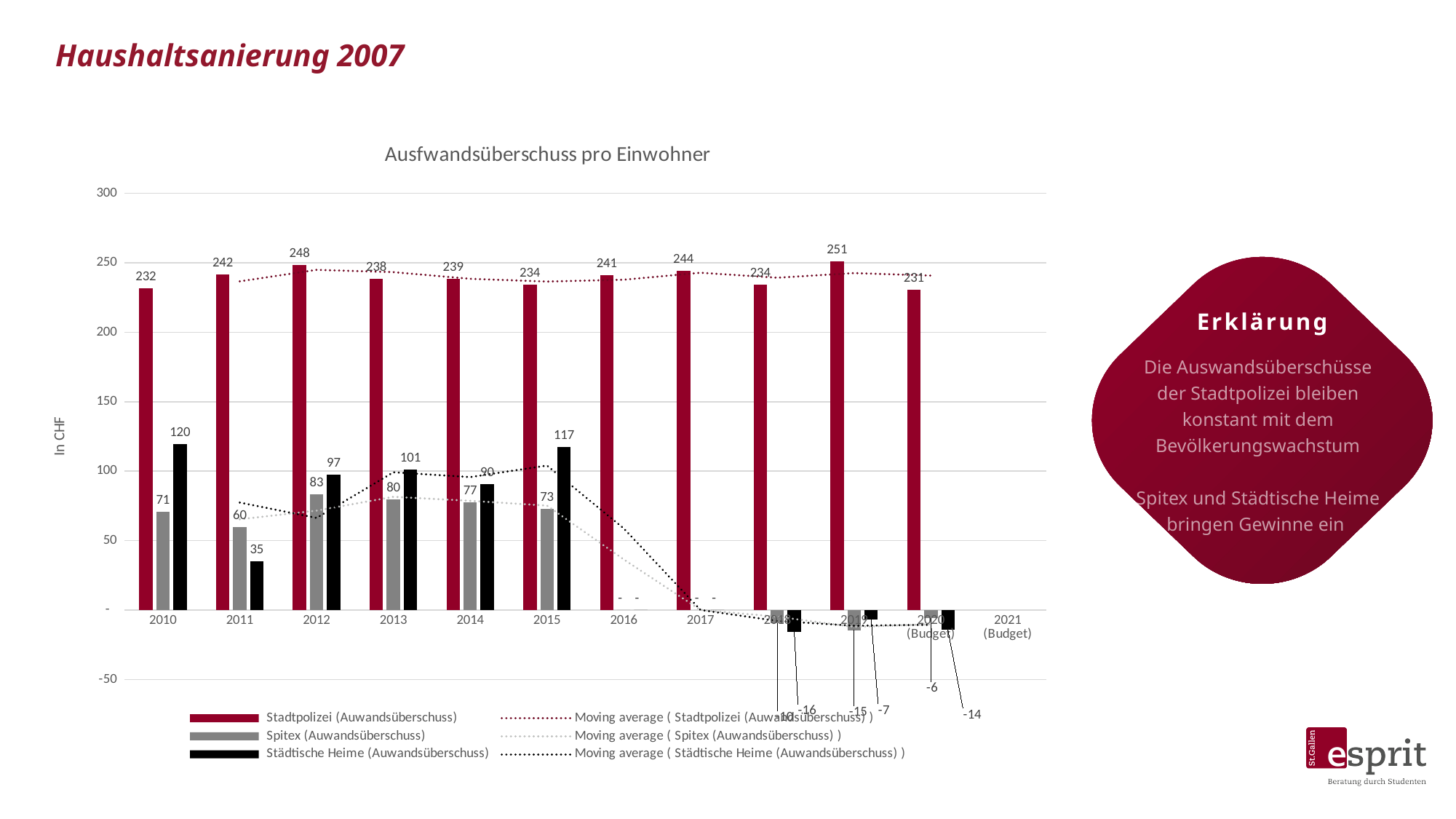
What is the difference between the Städtische Heime value in 2010 and in 2011? 85 What kind of chart is shown on the slide? Bar chart How many year categories are shown on the x axis? 12 What is the value for Stadtpolizei (Auwandsüberschuss) in 2012? 248 How many series does the legend list? 6 What is the label of the y axis? In CHF What is the difference between the Stadtpolizei value in 2019 and in 2020 (Budget)? 20 In 2013, which is larger: the Spitex value or the Städtische Heime value? Städtische Heime In which year is the Stadtpolizei (Auwandsüberschuss) value highest? 2019 In which year is the Städtische Heime (Auwandsüberschuss) value highest? 2010 What is the value for Spitex (Auwandsüberschuss) in 2010? 71 What is the value for Städtische Heime (Auwandsüberschuss) in 2015? 117